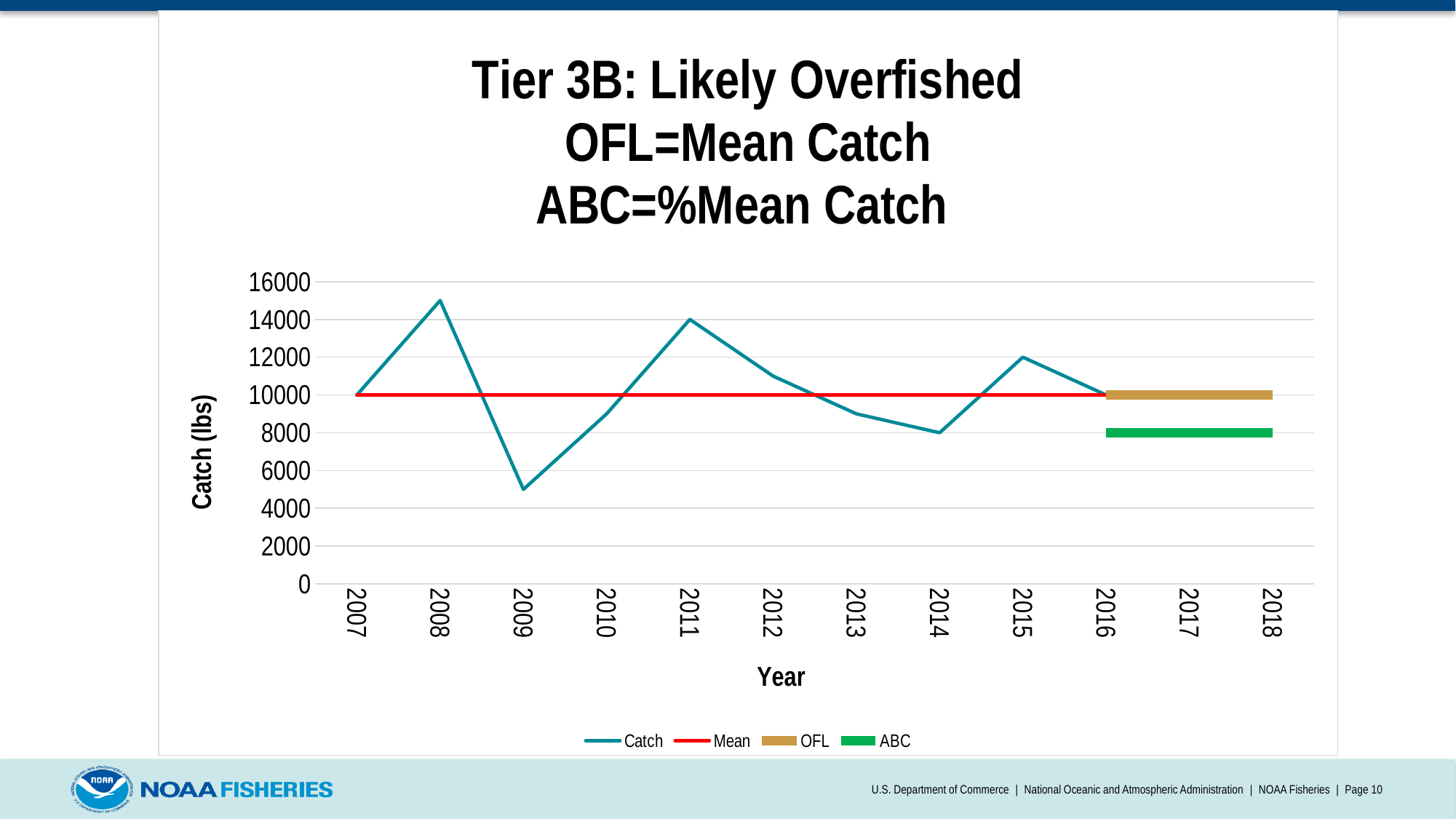
What is the ABC value shown for 2016 to 2018? 8000 Is the Catch value for 2012 greater or less than 10000? greater Is the Catch value for 2009 greater or less than 6000? less What kind of chart is shown on the slide? line chart Which is larger, the Catch in 2011 or the Catch in 2015? 2011 What is the value of the Mean line? 10000 In which year is the Catch highest? 2008 What is the Catch value in 2014? 8000 How many years are shown on the x axis? 12 How many series does the legend list? 4 Does the Catch rise or fall from 2011 to 2014? fall In which year is the Catch lowest? 2009